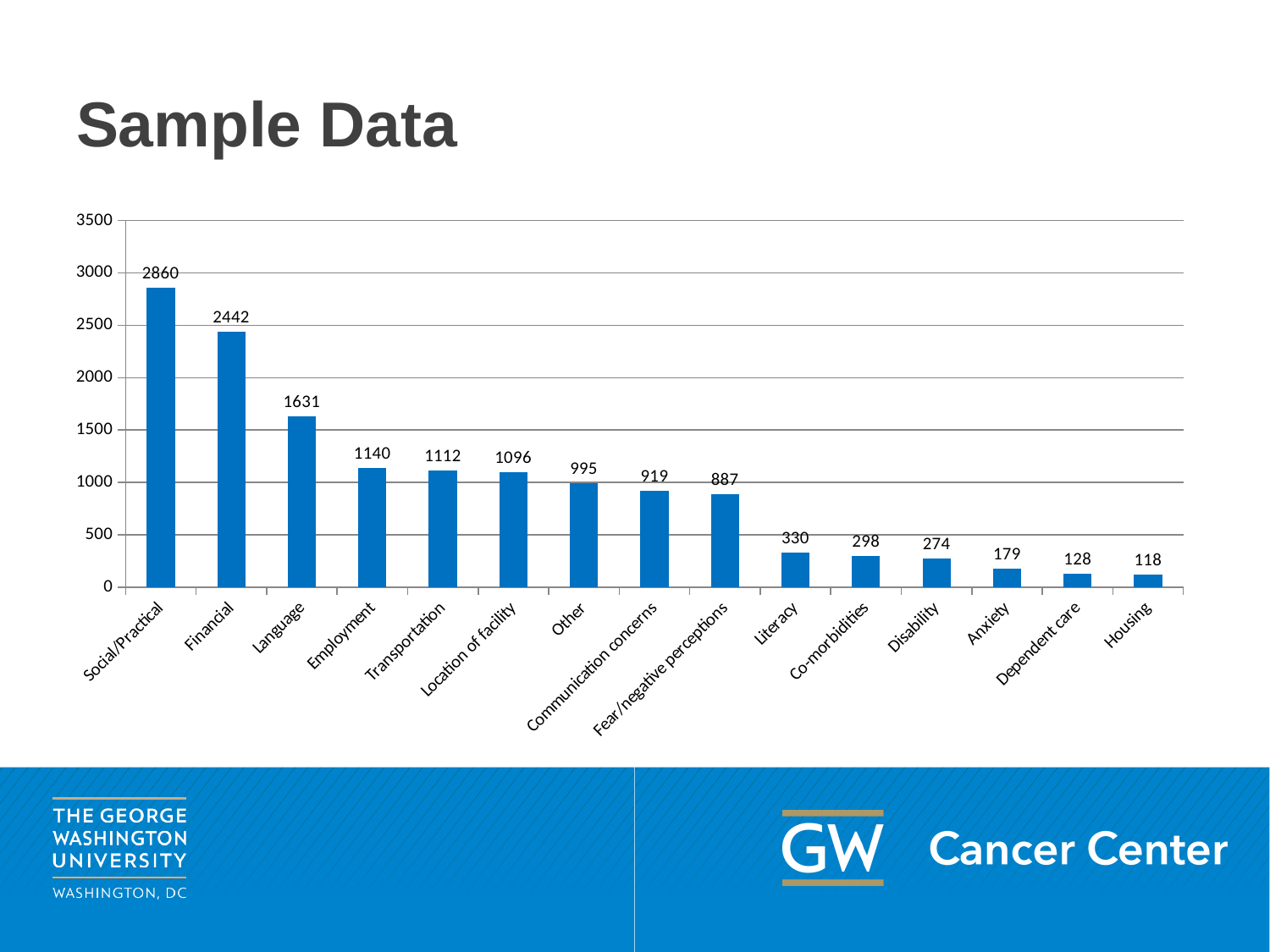
Which is larger, the value for Communication concerns or the value for Fear/negative perceptions? Communication concerns What kind of chart is shown on the slide? bar chart Which category has the lowest value? Housing What is the value for Social/Practical? 2860 What is the difference between the values for Social/Practical and Financial? 418 Which category has the highest value? Social/Practical What is the difference between the values for Language and Employment? 491 How many categories are shown on the x axis? 15 What is the value for Transportation? 1112 What is the value for Literacy? 330 Is the value for Language greater or less than 1500? greater Do the values rise or fall moving from left to right along the x axis? fall